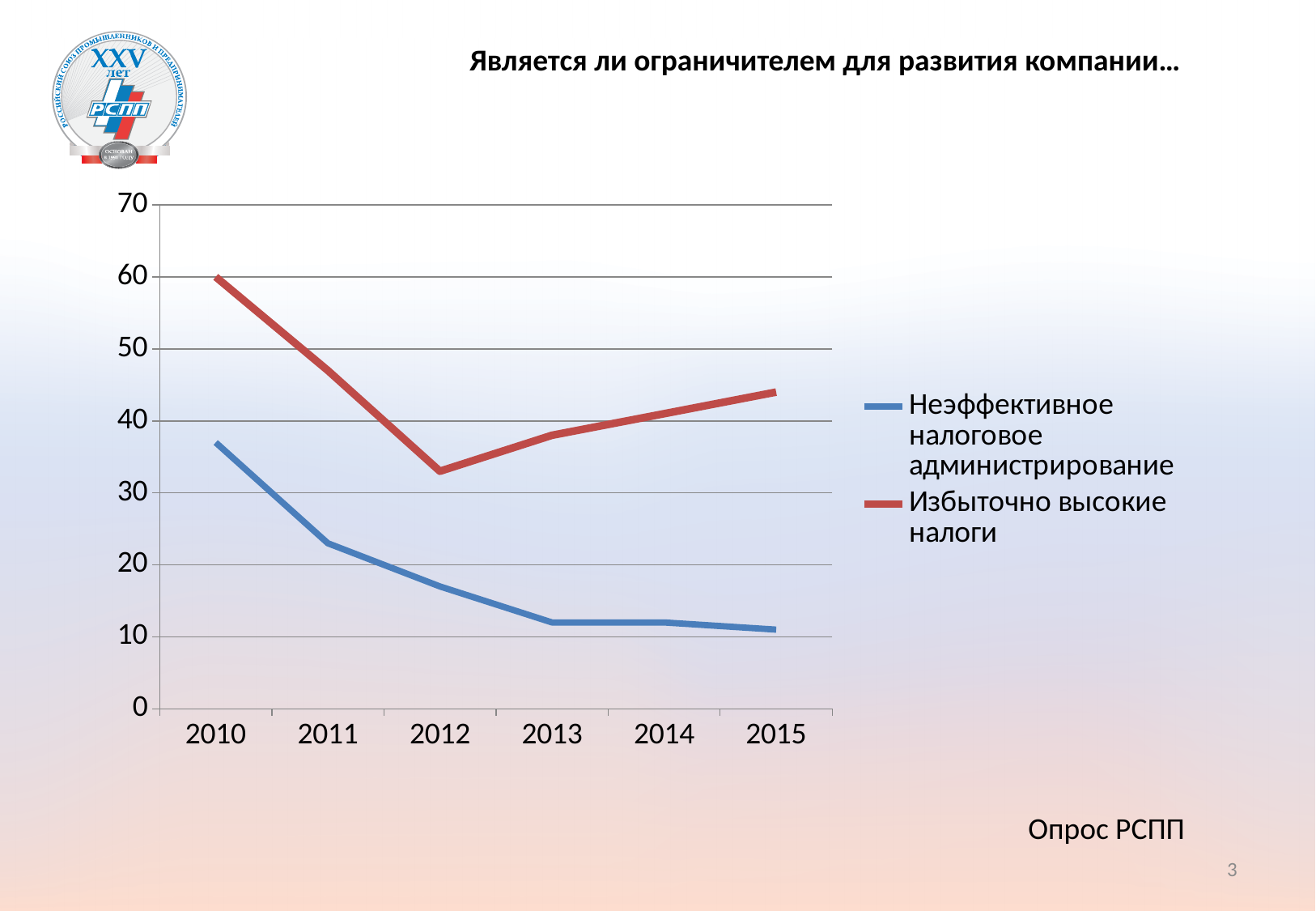
In which year is the value for "Неэффективное налоговое администрирование" highest? 2010 What kind of chart is shown on the slide? line chart Which series has the larger value in 2015, "Избыточно высокие налоги" or "Неэффективное налоговое администрирование"? Избыточно высокие налоги How many years are shown on the x axis? 6 Does the value for "Неэффективное налоговое администрирование" rise or fall from 2010 to 2015? fall How many series does the legend list? 2 Is the value for "Избыточно высокие налоги" in 2015 greater or less than 40? greater In which year is the value for "Избыточно высокие налоги" highest? 2010 What colour is the line for "Избыточно высокие налоги"? red In which year is the value for "Избыточно высокие налоги" lowest? 2012 Is the value for "Неэффективное налоговое администрирование" in 2013 greater or less than 20? less Is the value for "Избыточно высокие налоги" in 2010 greater or less than 50? greater